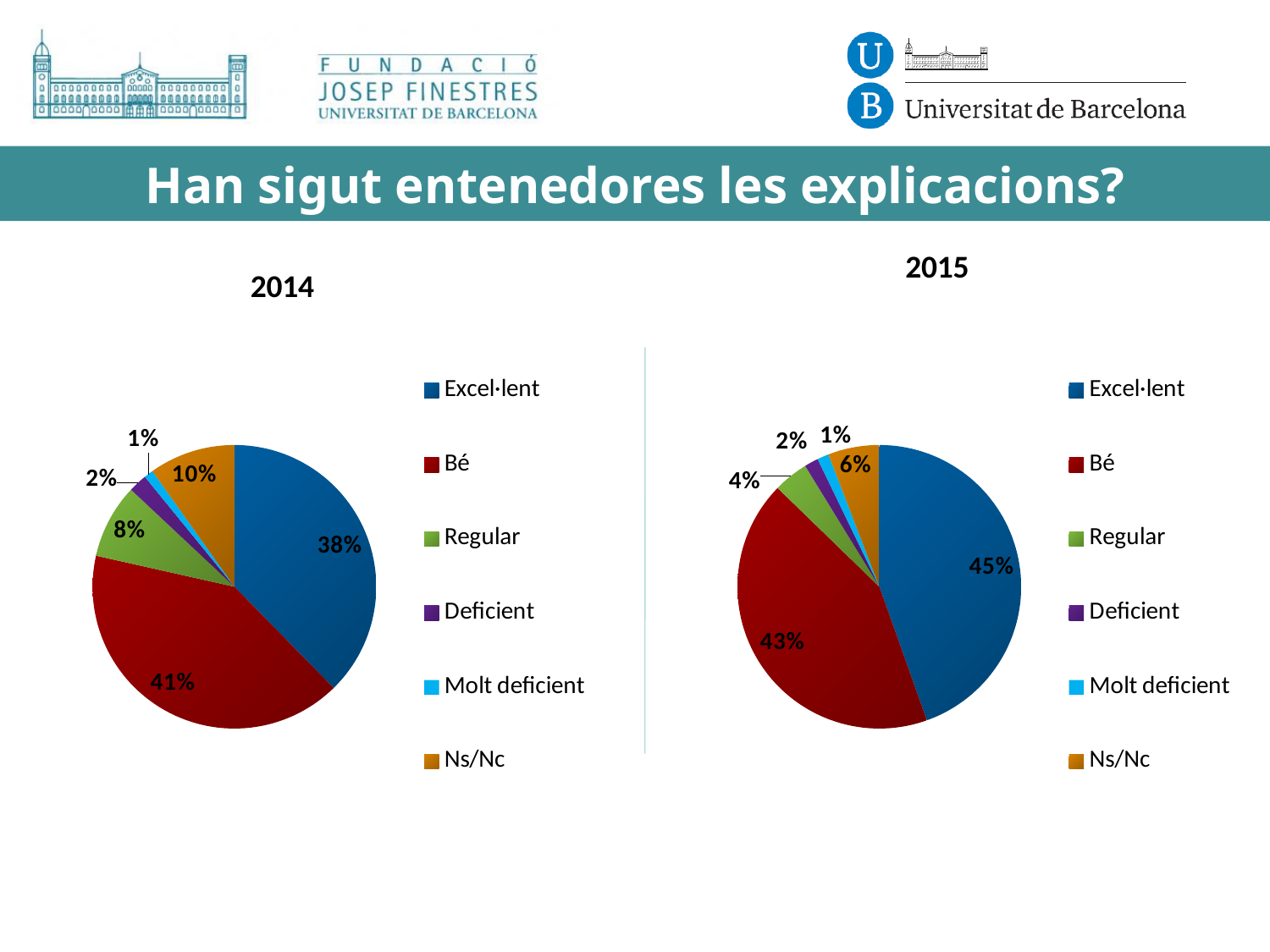
In the 2014 chart, what is the combined share of Excel·lent and Bé? 79% In the 2014 chart, what percentage is shown for Bé? 41% In the 2015 chart, which category has the smallest slice? Molt deficient In the 2014 chart, what percentage is shown for Ns/Nc? 10% In the 2015 chart, what is the difference between the Excel·lent and Bé percentages? 2% What kind of chart is used for the 2014 data? Pie chart In the 2014 chart, which is larger, the Regular slice or the Ns/Nc slice? Ns/Nc In the 2015 chart, what percentage is shown for Regular? 4% In the 2014 chart, which category has the largest slice? Bé In the 2015 chart, what percentage is shown for Excel·lent? 45% How many categories does the legend of the 2015 chart list? 6 What is the title of the slide containing the two charts? Han sigut entenedores les explicacions?